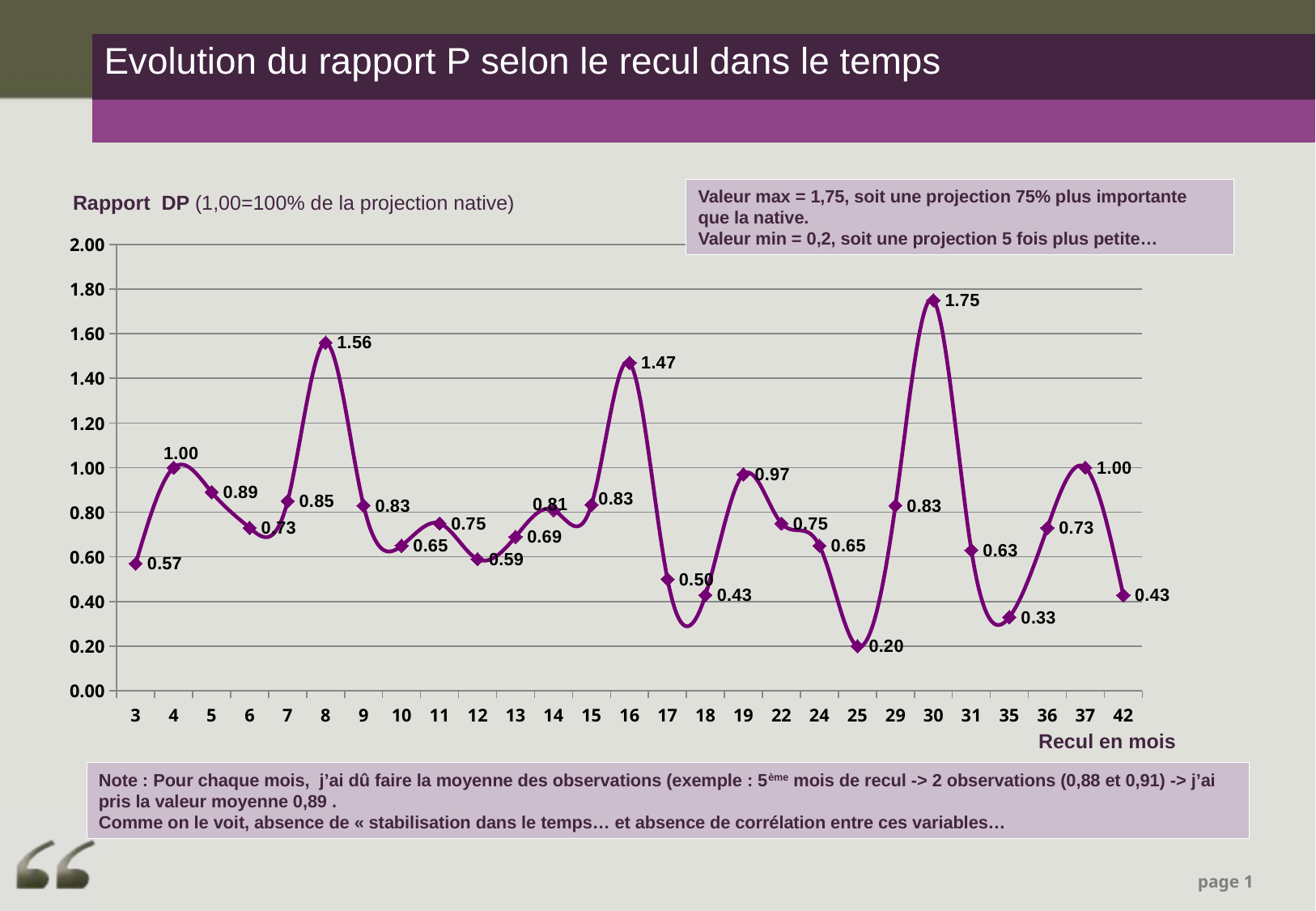
What is the Rapport DP value at 25 months of recul? 0.20 How many data points are plotted on the chart? 27 What is the difference between the Rapport DP at 4 months and at 3 months? 0.43 At which recul (in months) is the Rapport DP lowest? 25 Is the Rapport DP value at 35 months greater or less than 0.40? less What type of chart is shown on the slide? line chart What is the label of the x axis? Recul en mois At which recul (in months) is the Rapport DP highest? 30 What is the Rapport DP value at 8 months of recul? 1.56 What is the difference between the Rapport DP at 30 months and at 16 months? 0.28 What is the Rapport DP value at 42 months of recul? 0.43 Which has a higher Rapport DP: 19 months or 22 months of recul? 19 months